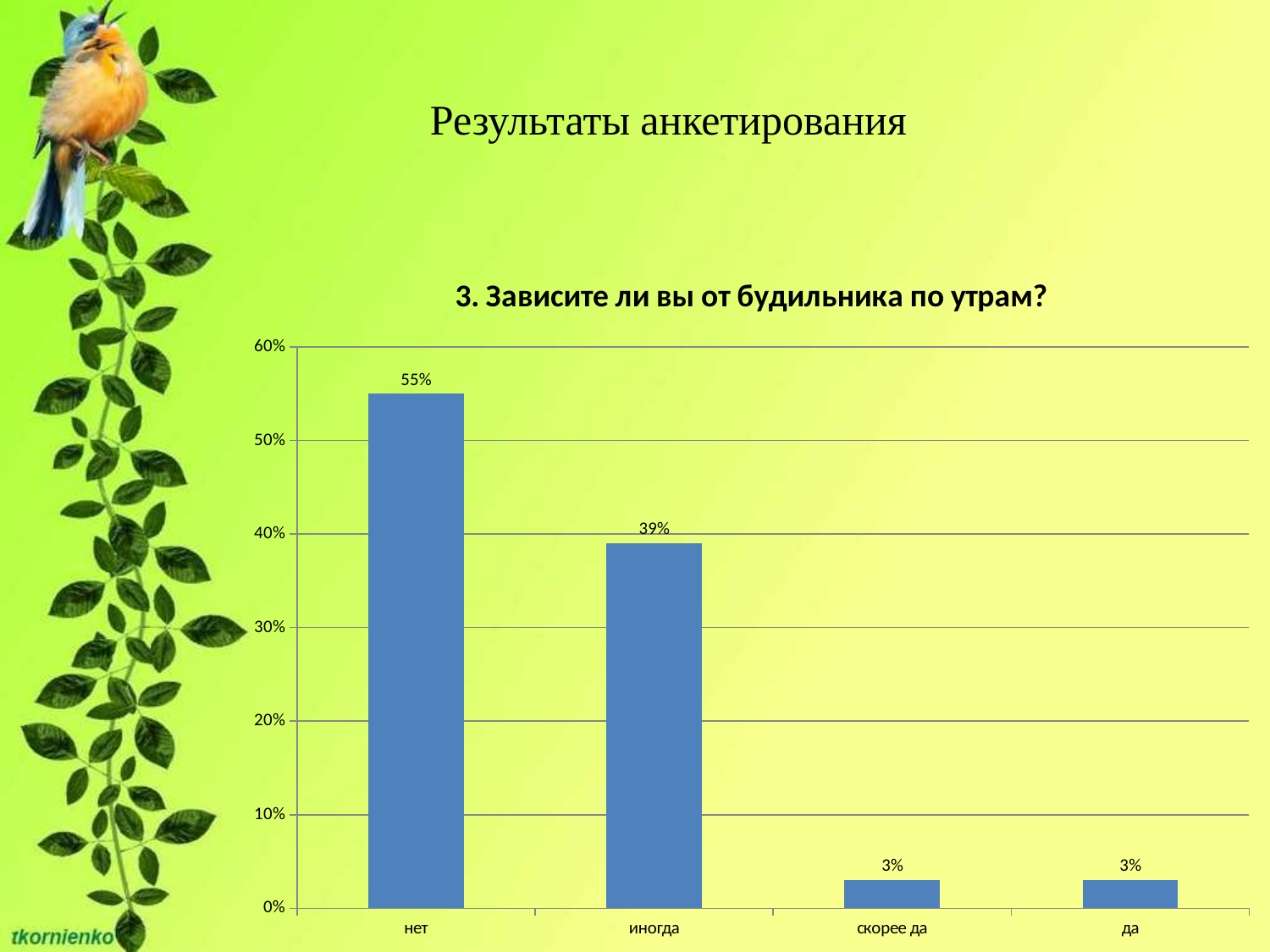
Is the value for "нет" greater or less than 50%? greater What is the value for "скорее да"? 3% Which category has the highest value? нет What kind of chart is shown on the slide? bar chart What is the value for "нет"? 55% What is the difference between the values for "нет" and "иногда"? 16% Is the value for "иногда" greater or less than 40%? less Which is larger, the value for "иногда" or the value for "скорее да"? иногда What is the value for "иногда"? 39% What is the value for "да"? 3% How many categories are shown on the x axis? 4 What is the title of the chart? 3. Зависите ли вы от будильника по утрам?